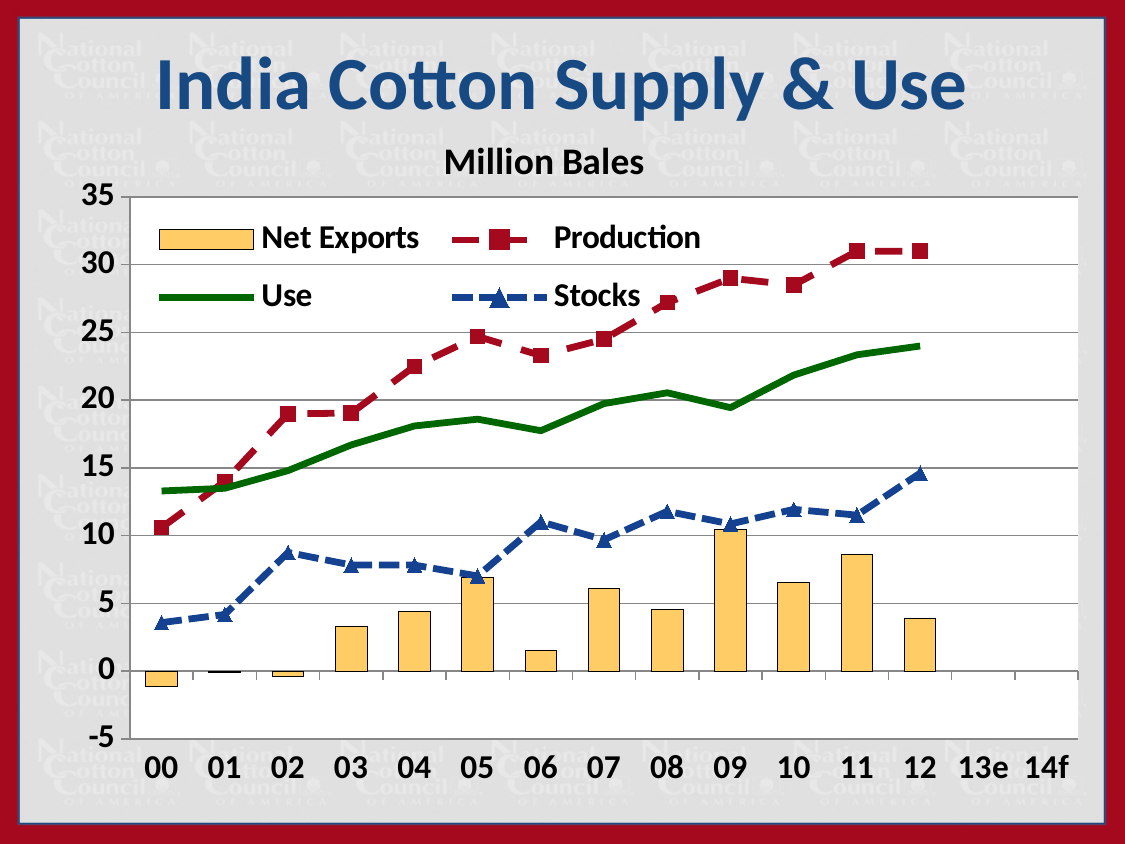
In which year are Net Exports lowest? 00 Does Production generally rise or fall from 00 to 12? rise How many series does the legend list? 4 Which series is shown as bars? Net Exports Is the value for Production in 12 greater or less than 30? greater What kind of chart is this? Combined bar and line chart Is the value for Use in 00 greater or less than 15? less In 08, which is larger, Production or Use? Production In which year are Net Exports highest? 09 In which year are Stocks lowest? 00 Is the value for Stocks in 12 greater or less than 10? greater